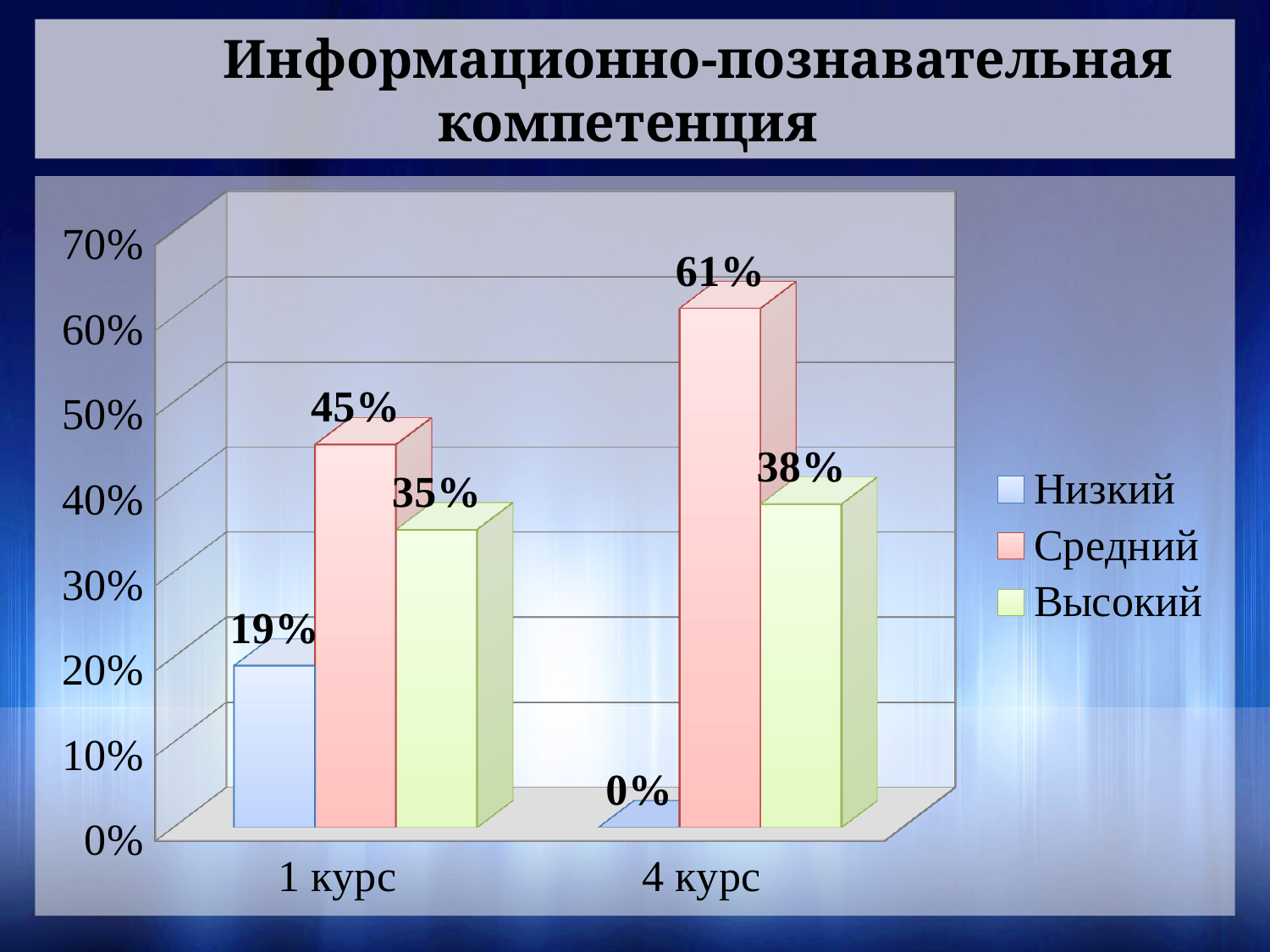
What is the value for Низкий in 4 курс? 0% What is the value for Средний in 4 курс? 61% What is the difference between the Средний values for 4 курс and 1 курс? 16% Which is larger: Высокий in 1 курс or Высокий in 4 курс? Высокий in 4 курс How many categories are shown on the x axis? 2 Which series has the lowest value in 1 курс? Низкий What is the title of the slide? Информационно-познавательная компетенция What is the value for Высокий in 1 курс? 35% How many series does the legend list? 3 Which series has the highest value in 4 курс? Средний What kind of chart is shown on the slide? Bar chart What is the value for Средний in 1 курс? 45%